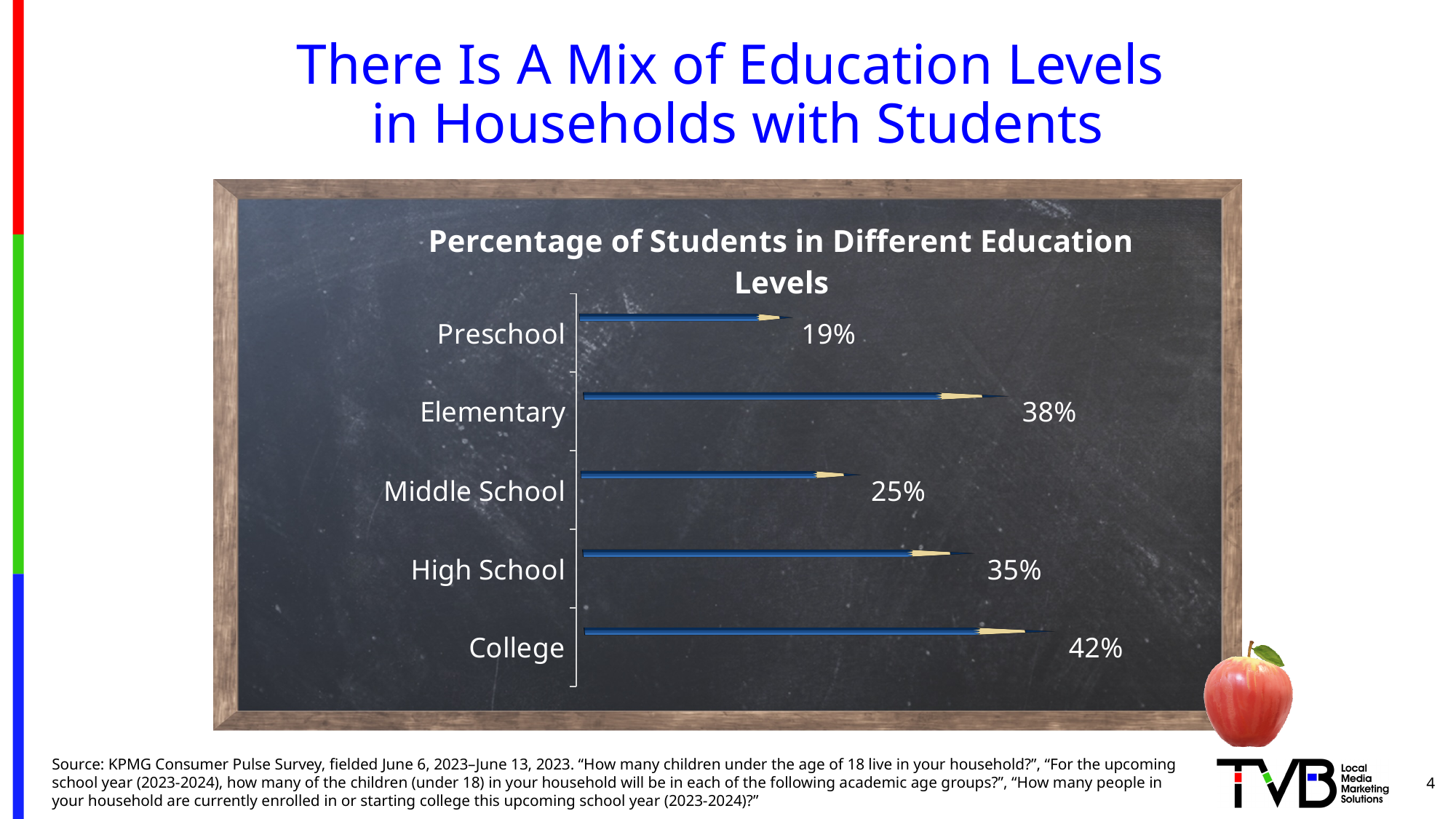
Which education level has the lowest percentage of students? Preschool Which education level has the highest percentage of students? College Which has a higher percentage of students, Elementary or High School? Elementary How many education levels are shown in the chart? 5 What percentage of students are in College? 42% What percentage of students are in Elementary? 38% What percentage of students are in Preschool? 19% What is the title of the chart? Percentage of Students in Different Education Levels What type of chart is used to show the percentage of students in different education levels? Bar chart What percentage of students are in Middle School? 25% What percentage of students are in High School? 35% What is the difference in percentage points between College and Preschool? 23